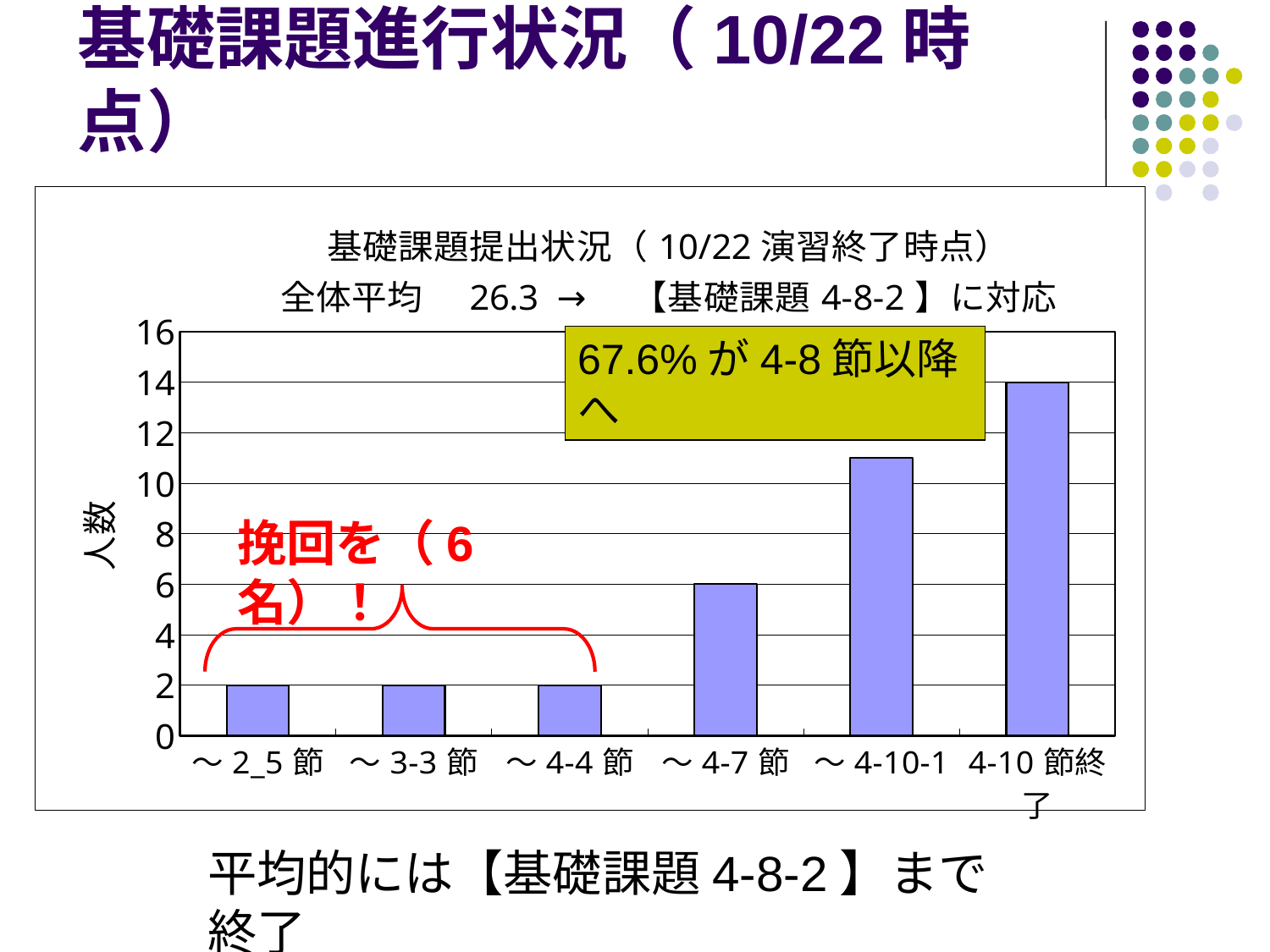
Which category has the highest value? 4-10節終了 Is the value for ～4-10-1 greater or less than 10? greater What is the value (人数) for 4-10節終了? 14 What is the value (人数) for ～2_5節? 2 What is the value (人数) for ～4-7節? 6 How many categories have a value of 2? 3 What is the difference between the values for 4-10節終了 and ～4-7節? 8 What is the label of the vertical axis? 人数 Do the values generally rise or fall from left to right along the x axis? rise How many categories are shown on the x axis of the chart? 6 Which has a larger value, ～4-4節 or ～4-7節? ～4-7節 What kind of chart is shown on the slide? bar chart